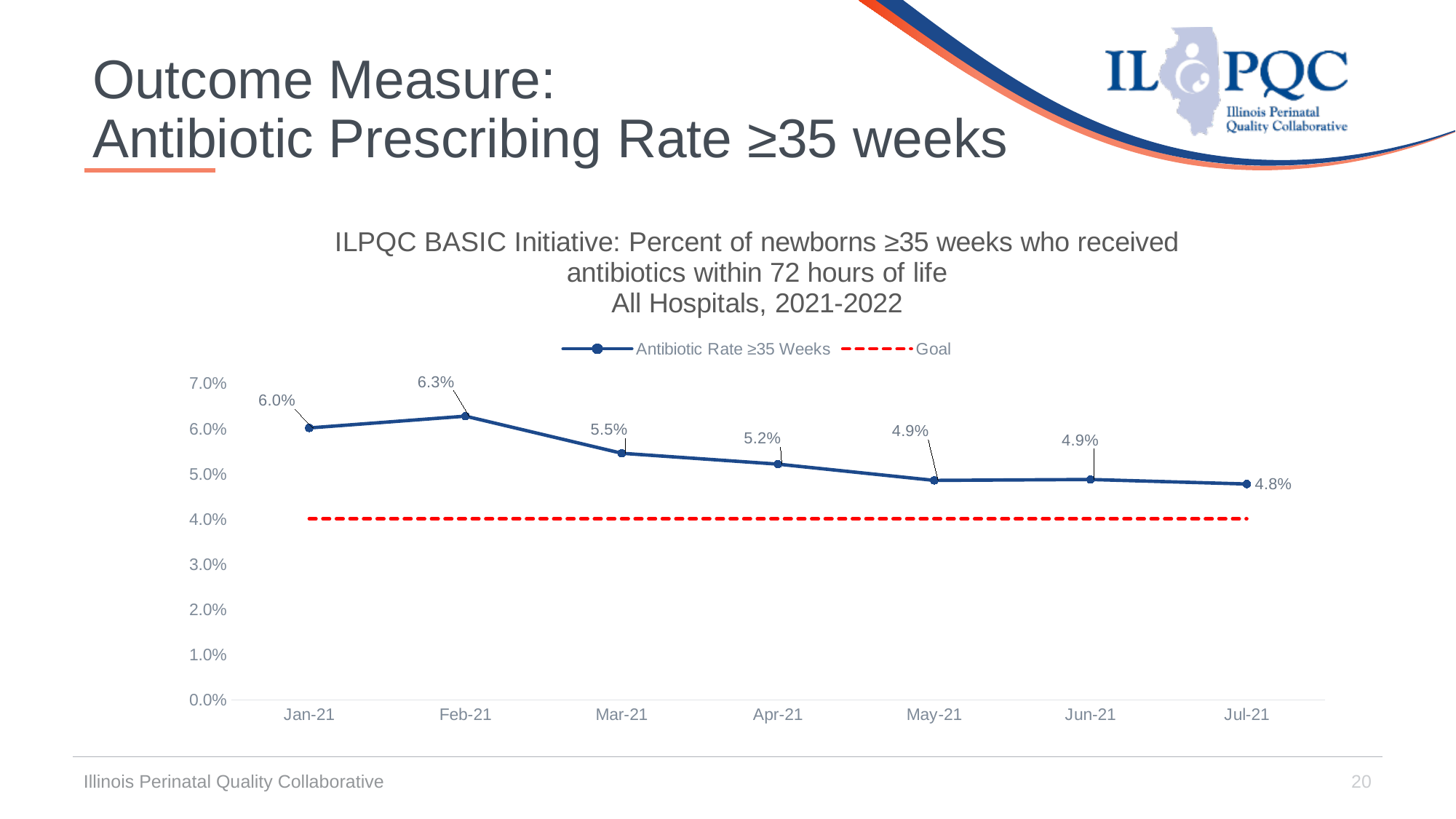
What is the antibiotic rate ≥35 weeks for Jul-21? 4.8% Does the antibiotic rate ≥35 weeks generally rise or fall from Feb-21 to Jul-21? fall What is the antibiotic rate ≥35 weeks for Jan-21? 6.0% How many months are plotted on the x axis? 7 Which month has the lowest antibiotic rate ≥35 weeks? Jul-21 What is the difference between the antibiotic rate in Feb-21 and Jul-21? 1.5% Is the Goal line value greater or less than 5.0%? less What is the antibiotic rate ≥35 weeks for Mar-21? 5.5% What kind of chart is shown on the slide? line chart How many series does the legend list? 2 Which month has the highest antibiotic rate ≥35 weeks? Feb-21 Which month has a higher antibiotic rate, Jan-21 or Apr-21? Jan-21